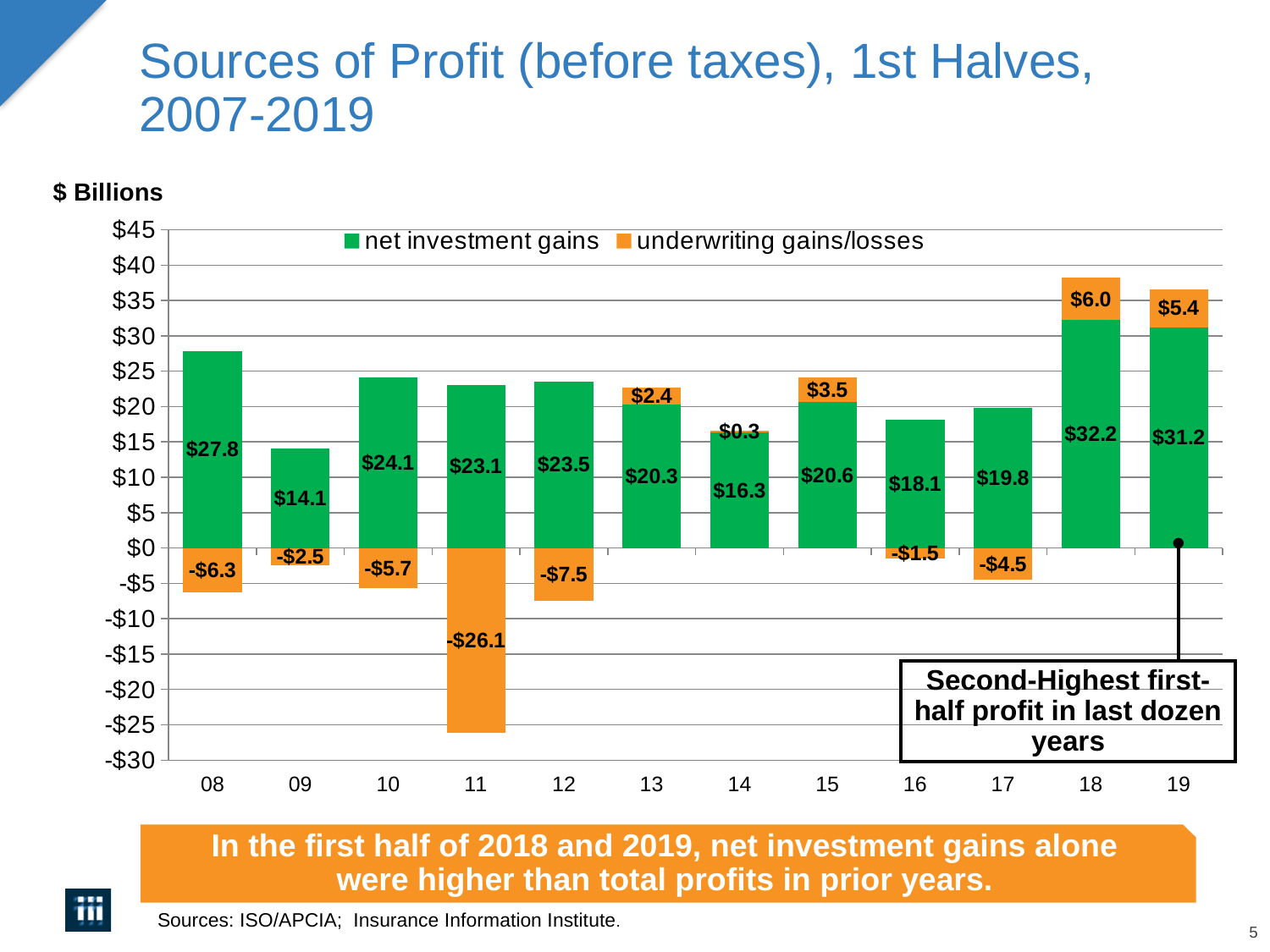
What is the value of underwriting gains/losses for 11? -$26.1 Which is larger, net investment gains in 10 or in 12? 10 What kind of chart is shown on the slide? Stacked bar chart How many years are shown on the x axis? 12 What is the total of the stacked bar for 18 (net investment gains plus underwriting gains)? $38.2 What is the difference between net investment gains in 08 and 09? $13.7 Which year has the highest net investment gains? 18 Which year has the lowest underwriting gains/losses value? 11 How many series does the legend list? 2 Which year has the lowest net investment gains? 09 What is the value of underwriting gains/losses for 14? $0.3 What is the value of net investment gains for 18? $32.2